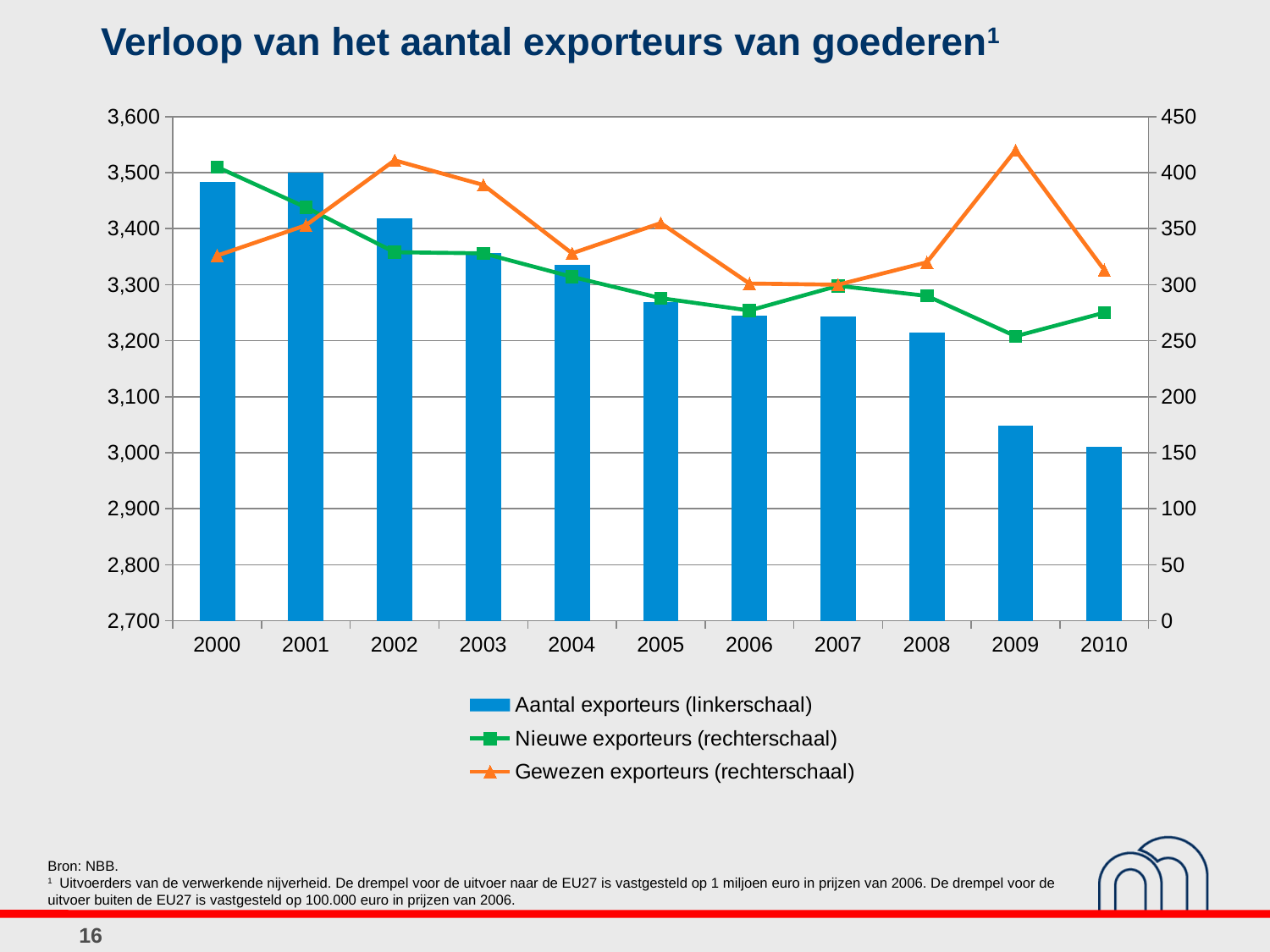
What kind of chart is shown on the slide? A combination bar and line chart How many series does the legend list? 3 Is the value for Gewezen exporteurs in 2009 greater or less than 400? greater Which series is plotted as bars? Aantal exporteurs (linkerschaal) Is the value for Nieuwe exporteurs in 2009 greater or less than 300? less In which year is the Aantal exporteurs bar the lowest? 2010 In which year does the Gewezen exporteurs line reach its highest value? 2009 In which year does the Nieuwe exporteurs line reach its lowest value? 2009 How many years are shown on the x axis? 11 Is the value for Aantal exporteurs in 2010 greater or less than 3,100? less In 2009, which is larger: Nieuwe exporteurs or Gewezen exporteurs? Gewezen exporteurs Does the Aantal exporteurs series generally rise or fall from 2000 to 2010? fall